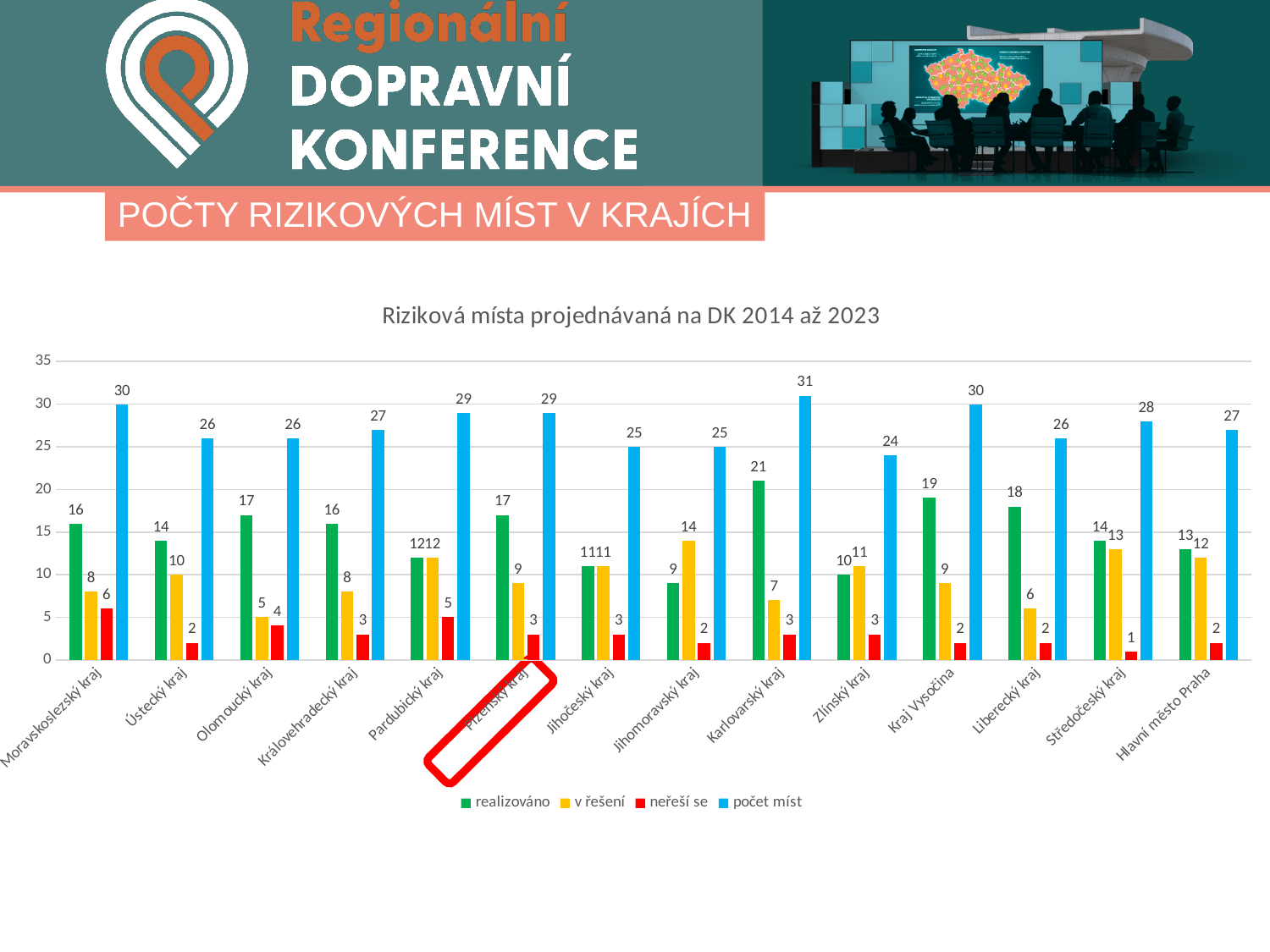
What is the value of 'realizováno' for Plzeňský kraj? 17 What type of chart is shown on the slide? Bar chart How many series does the legend list? 4 What is the difference between 'počet míst' and 'realizováno' for Kraj Vysočina? 11 What is the value of 'neřeší se' for Moravskoslezský kraj? 6 What is the value of 'v řešení' for Jihomoravský kraj? 14 Which region has the highest 'realizováno' value? Karlovarský kraj What is the value of 'počet míst' for Karlovarský kraj? 31 Which region has the highest 'počet míst' value? Karlovarský kraj How many regions (categories) are shown on the x axis? 14 Which region has the lowest 'neřeší se' value? Středočeský kraj Which is larger for Liberecký kraj: 'realizováno' or 'v řešení'? realizováno